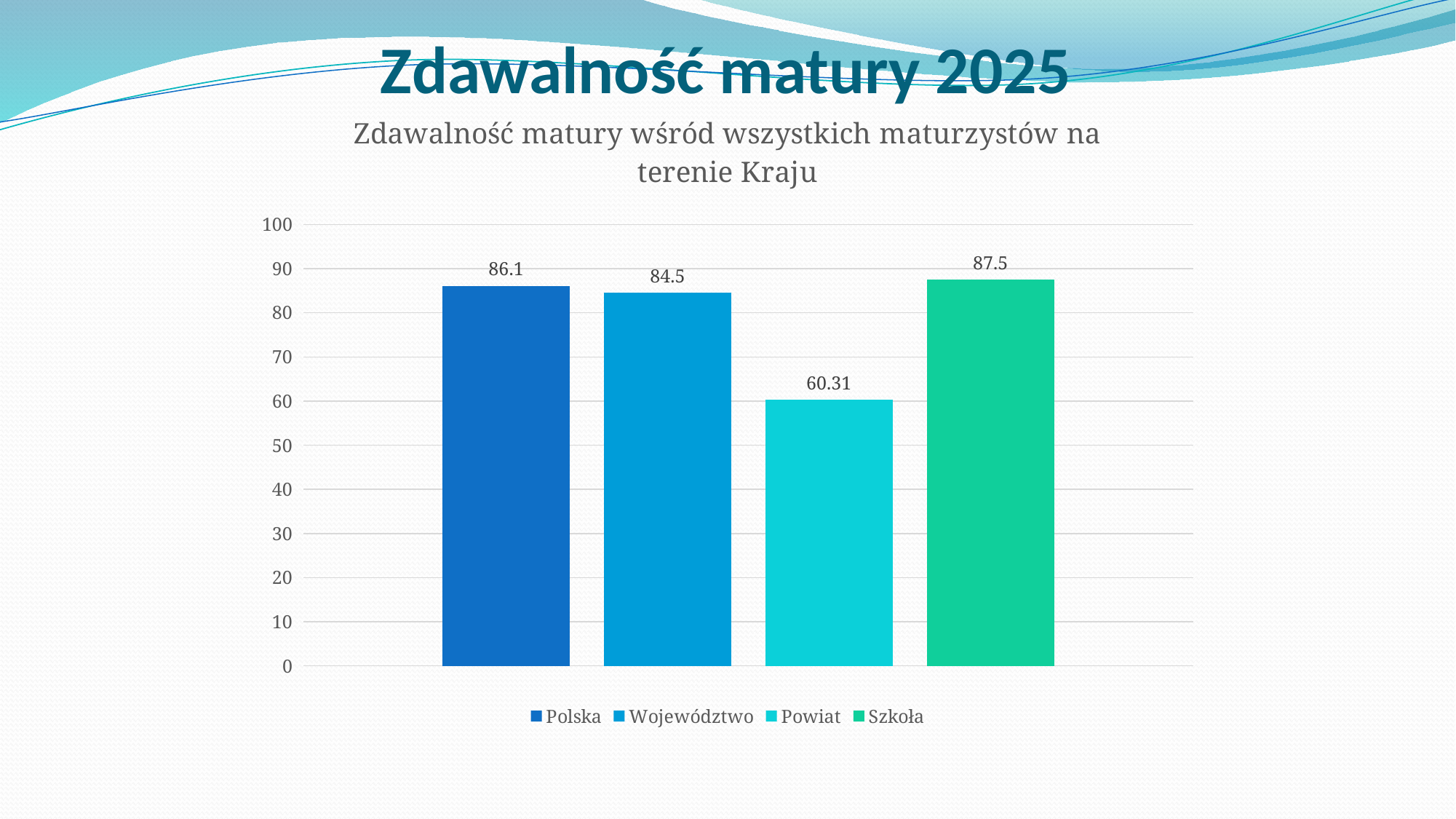
What is the value for Powiat? 60.31 What is the value for Województwo? 84.5 Which is larger, the value for Polska or the value for Powiat? Polska Which series has the lowest value? Powiat What is the difference between the values for Polska and Województwo? 1.6 What is the value for Polska? 86.1 What is the difference between the values for Szkoła and Powiat? 27.19 What kind of chart is shown on the slide? bar chart What is the value for Szkoła? 87.5 Which series has the highest value? Szkoła How many series does the legend list? 4 What is the title of the chart? Zdawalność matury wśród wszystkich maturzystów na terenie Kraju